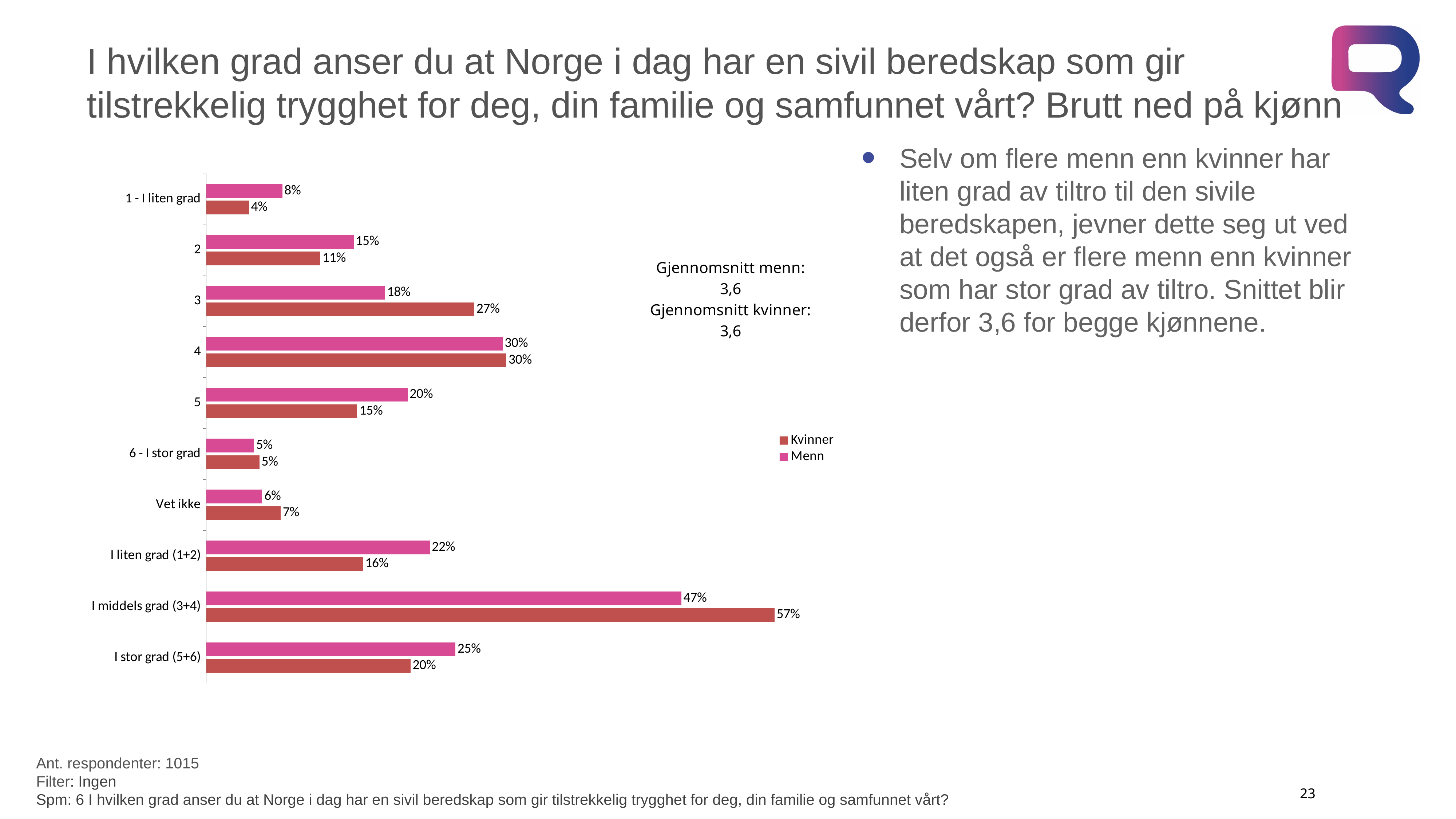
Which series is shown in pink in the legend? Menn What kind of chart is shown on the slide? Bar chart What is the difference between the Kvinner and Menn values in the category "I middels grad (3+4)"? 10% In the category "5", which series has the larger value, Kvinner or Menn? Menn How many series does the legend list? 2 What is the value for Menn in the category "3"? 18% What is the value for Menn in the category "I stor grad (5+6)"? 25% Which category has the lowest value for Kvinner? 1 - I liten grad How many categories are shown on the chart? 10 What is the value for Kvinner in the category "1 - I liten grad"? 4% What is the value for Kvinner in the category "I middels grad (3+4)"? 57% Which category has the highest value for Kvinner? I middels grad (3+4)